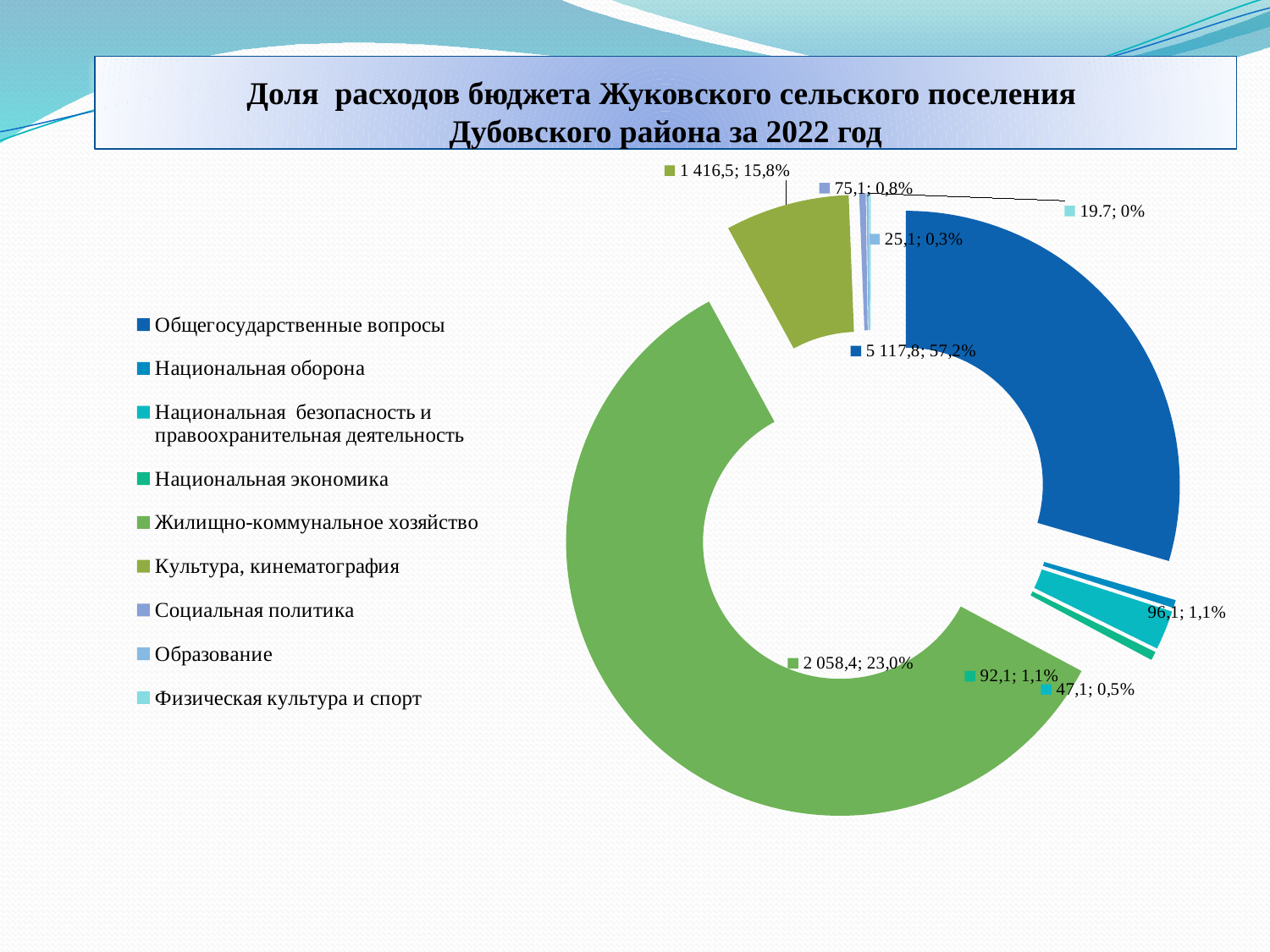
What share of the budget expenditure does the largest slice (Общегосударственные вопросы) represent? 57,2% What kind of chart is shown on the slide? pie chart (doughnut) What share does the Культура, кинематография slice represent? 15,8% What is the value shown for the Культура, кинематография slice? 1 416,5 What share does the Жилищно-коммунальное хозяйство slice represent? 23,0% What is the value shown for the Общегосударственные вопросы slice? 5 117,8 Which category has the largest share of expenditure? Общегосударственные вопросы How many categories does the legend of the chart list? 9 What is the value shown for the Жилищно-коммунальное хозяйство slice? 2 058,4 Which is larger: the value for Жилищно-коммунальное хозяйство or for Культура, кинематография? Жилищно-коммунальное хозяйство Which category has the smallest share of expenditure? Физическая культура и спорт What is the title of the chart on the slide? Доля расходов бюджета Жуковского сельского поселения Дубовского района за 2022 год